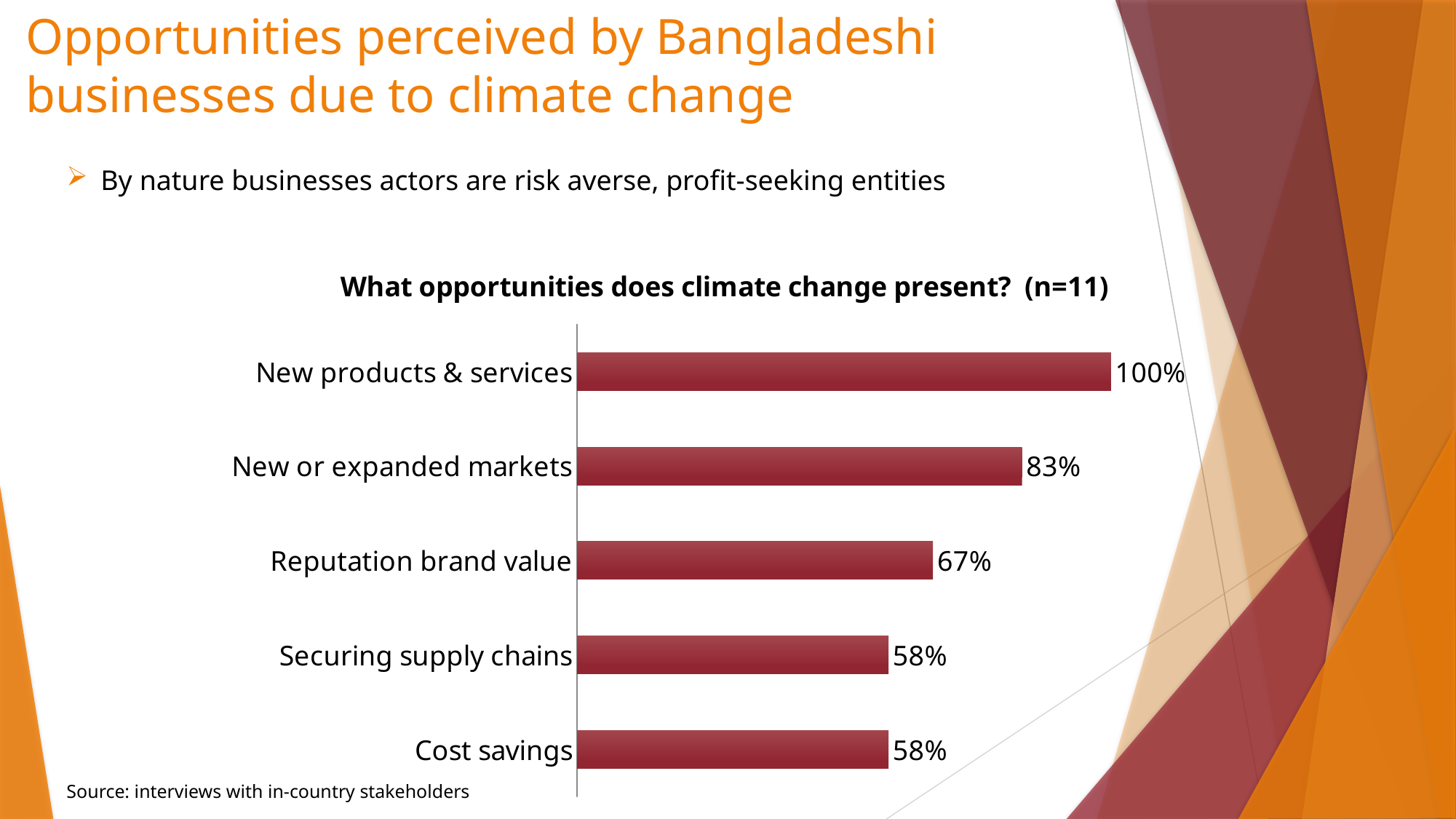
Which two categories share the same value of 58%? Securing supply chains and Cost savings What is the difference between the values for New products & services and New or expanded markets? 17% What is the value for New products & services? 100% What is the value for Reputation brand value? 67% Which category has the highest value? New products & services What is the value for Securing supply chains? 58% What is the difference between the values for New or expanded markets and Reputation brand value? 16% What kind of chart is shown on the slide? Bar chart Which is larger, the value for Reputation brand value or the value for Securing supply chains? Reputation brand value How many categories are shown in the chart? 5 What is the title of the chart? What opportunities does climate change present? (n=11) What is the value for New or expanded markets? 83%